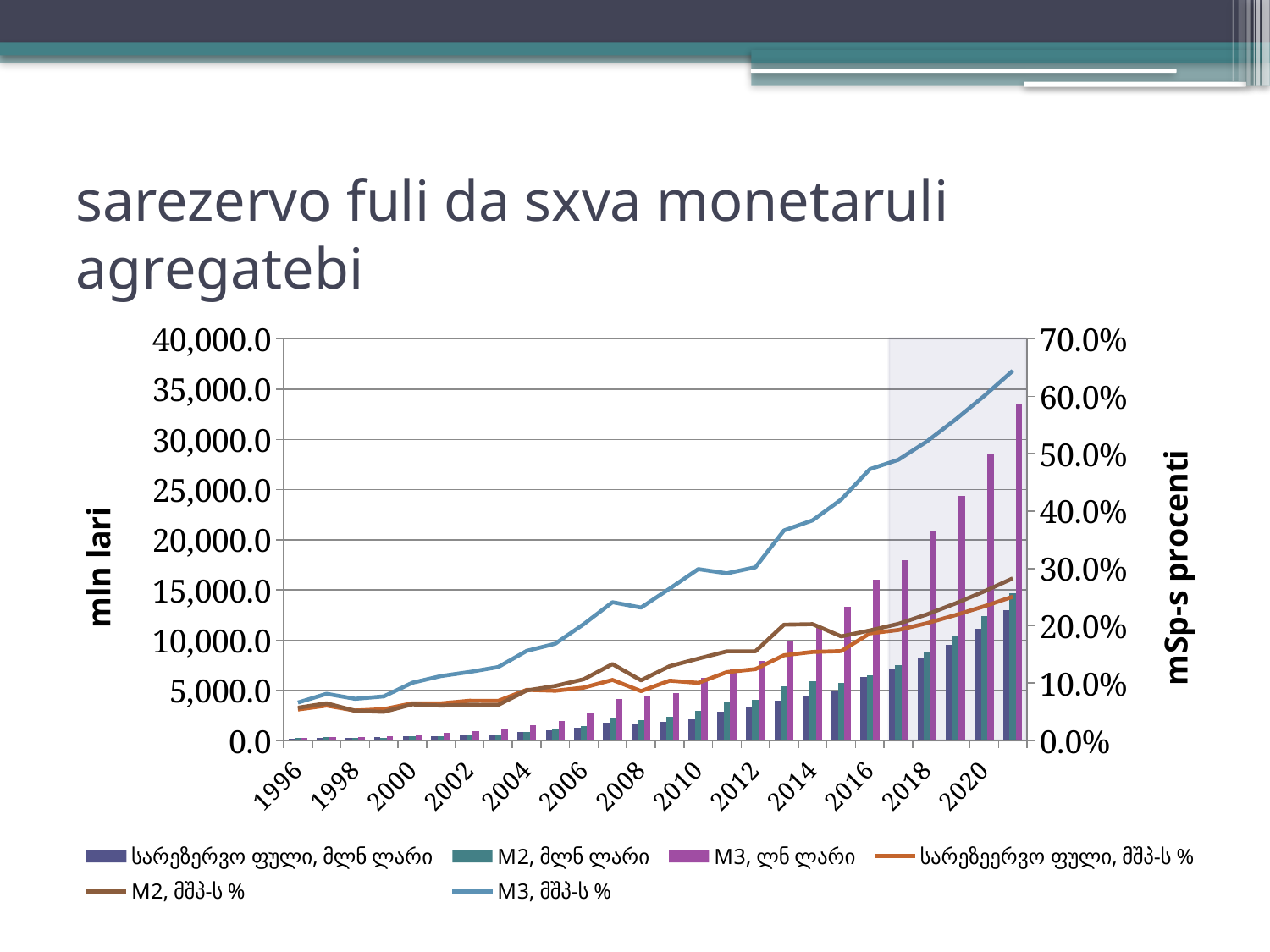
Which bar series has the highest value in 2020? M3, ლნ ლარი Is the value of the M3, მშპ-ს % line for 1996 greater or less than 10.0%? less Do the M3, ლნ ლარი bars rise or fall along the x axis from 1996 to 2020? rise What is the title of the right vertical axis? mSp-s procenti In 2020, which is larger: the M3, ლნ ლარი bar or the M2, მლნ ლარი bar? M3, ლნ ლარი Is the value of the M3, ლნ ლარი bar for 2020 greater or less than 20,000.0? greater Is the value of the სარეზერვო ფული, მლნ ლარი bar for 2010 greater or less than 5,000.0? less What kind of chart is shown on the slide? A combined bar and line chart Does the M3, მშპ-ს % line rise or fall from 1996 to the end of the period? rise How many series does the legend list? 6 What is the title of the left vertical axis? mln lari